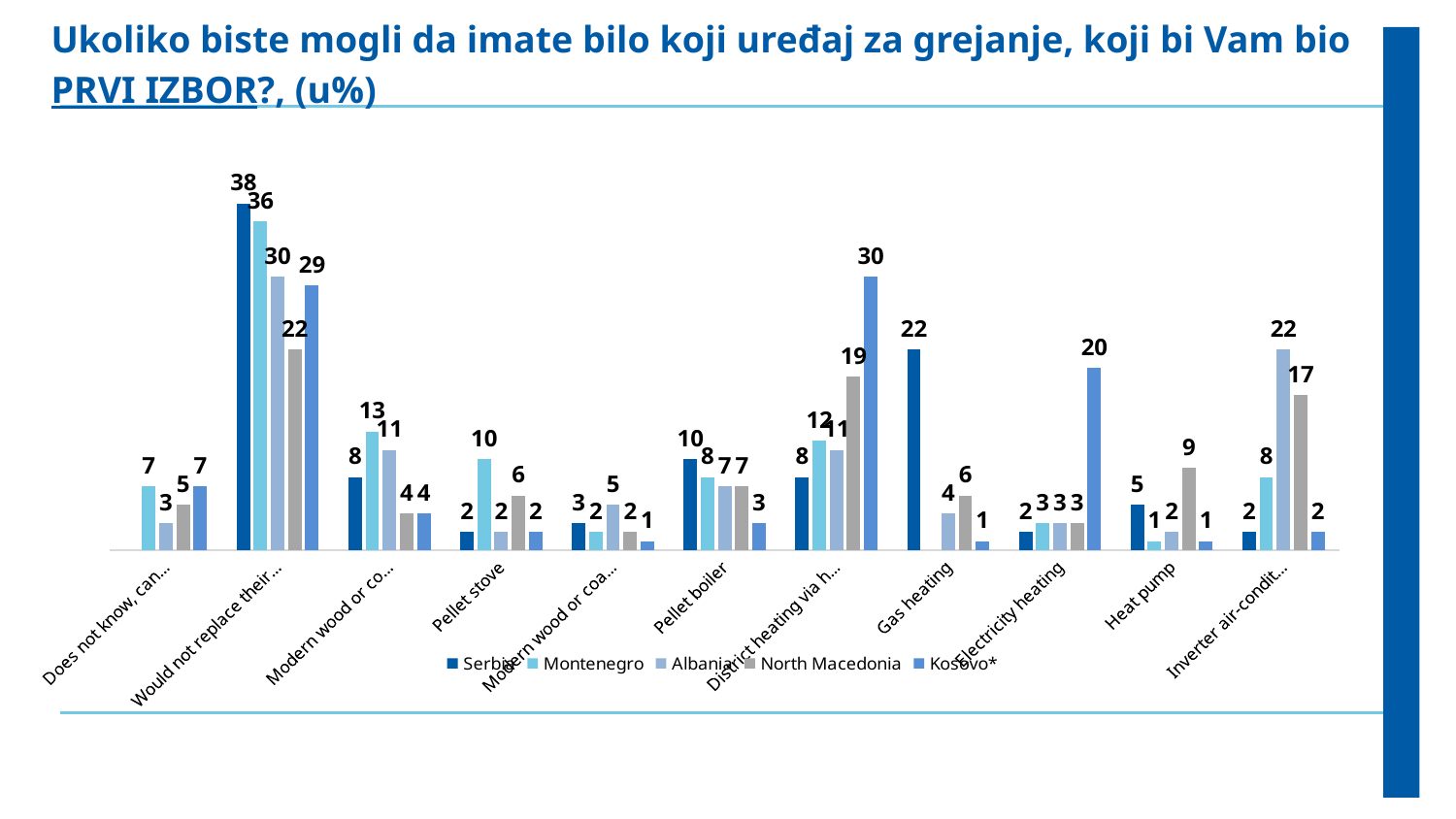
What is the value for Kosovo* in the Electricity heating category? 20 What kind of chart is shown on the slide? bar chart In the Pellet stove category, what is the difference between the values for Montenegro and North Macedonia? 4 How many series does the legend list? 5 What is the value for North Macedonia in the Heat pump category? 9 Which country has the highest value in the District heating category? Kosovo* In the Gas heating category, which is larger: the value for Albania or for North Macedonia? North Macedonia In the Electricity heating category, what is the difference between the values for Kosovo* and Serbia? 18 Which country has the lowest value in the Pellet boiler category? Kosovo* Which country has the highest value in the Heat pump category? North Macedonia What is the value for Serbia in the Gas heating category? 22 What is the value for Montenegro in the Pellet stove category? 10